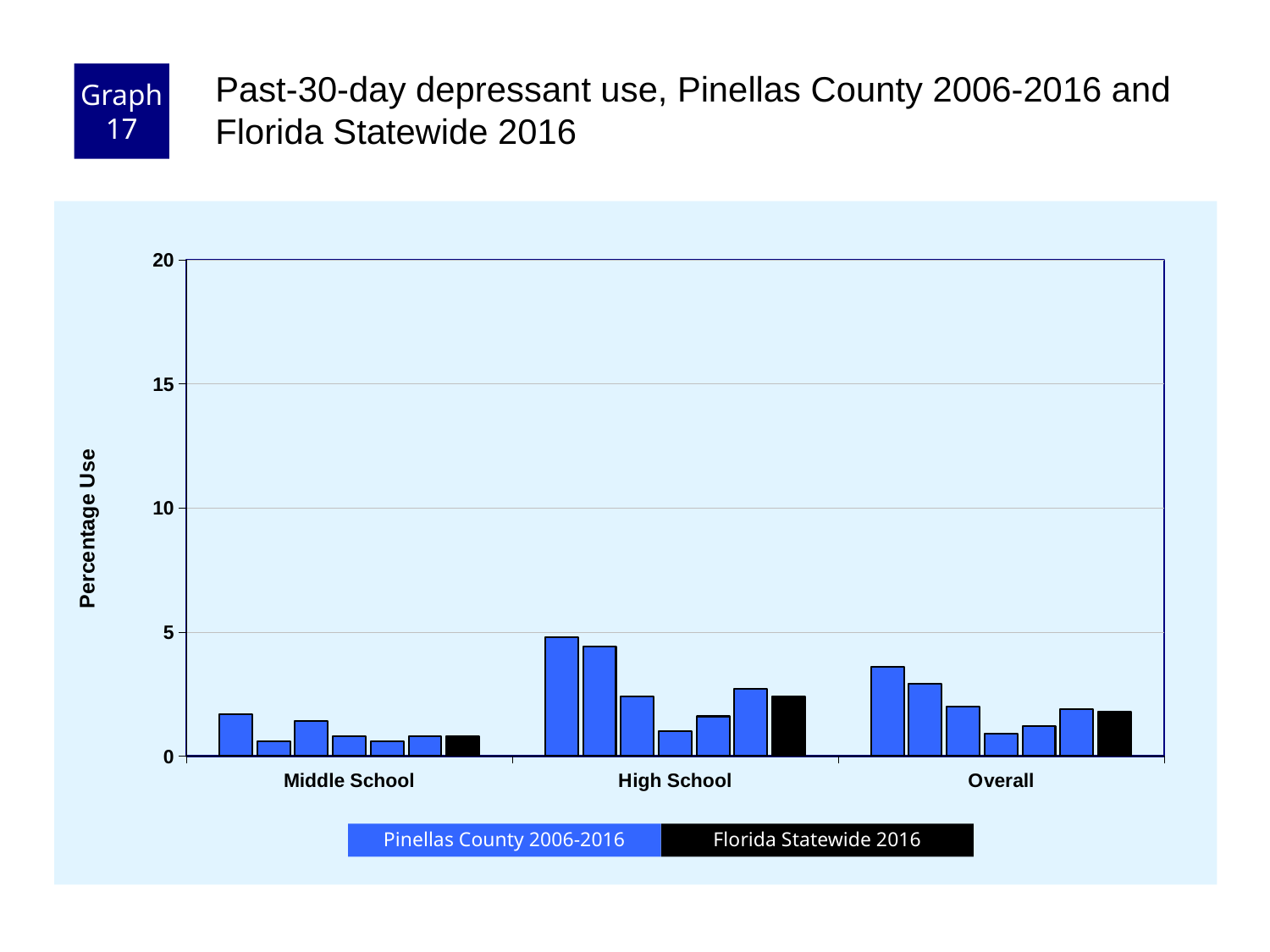
What kind of chart is shown on the slide? bar chart How many categories are shown on the x axis? 3 How many bars are plotted in the High School group? 7 Which is larger, the Florida Statewide 2016 value for High School or for Middle School? High School How many series does the legend list? 2 What is the label on the y axis? Percentage Use Is the Florida Statewide 2016 value for Middle School greater or less than 5? less Which is larger, the Florida Statewide 2016 value for Overall or for Middle School? Overall Which category group contains the tallest bar on the chart? High School Which category has the lowest Florida Statewide 2016 bar? Middle School Is the Florida Statewide 2016 value for High School greater or less than 5? less Is the tallest Pinellas County bar in the High School group greater or less than 10? less